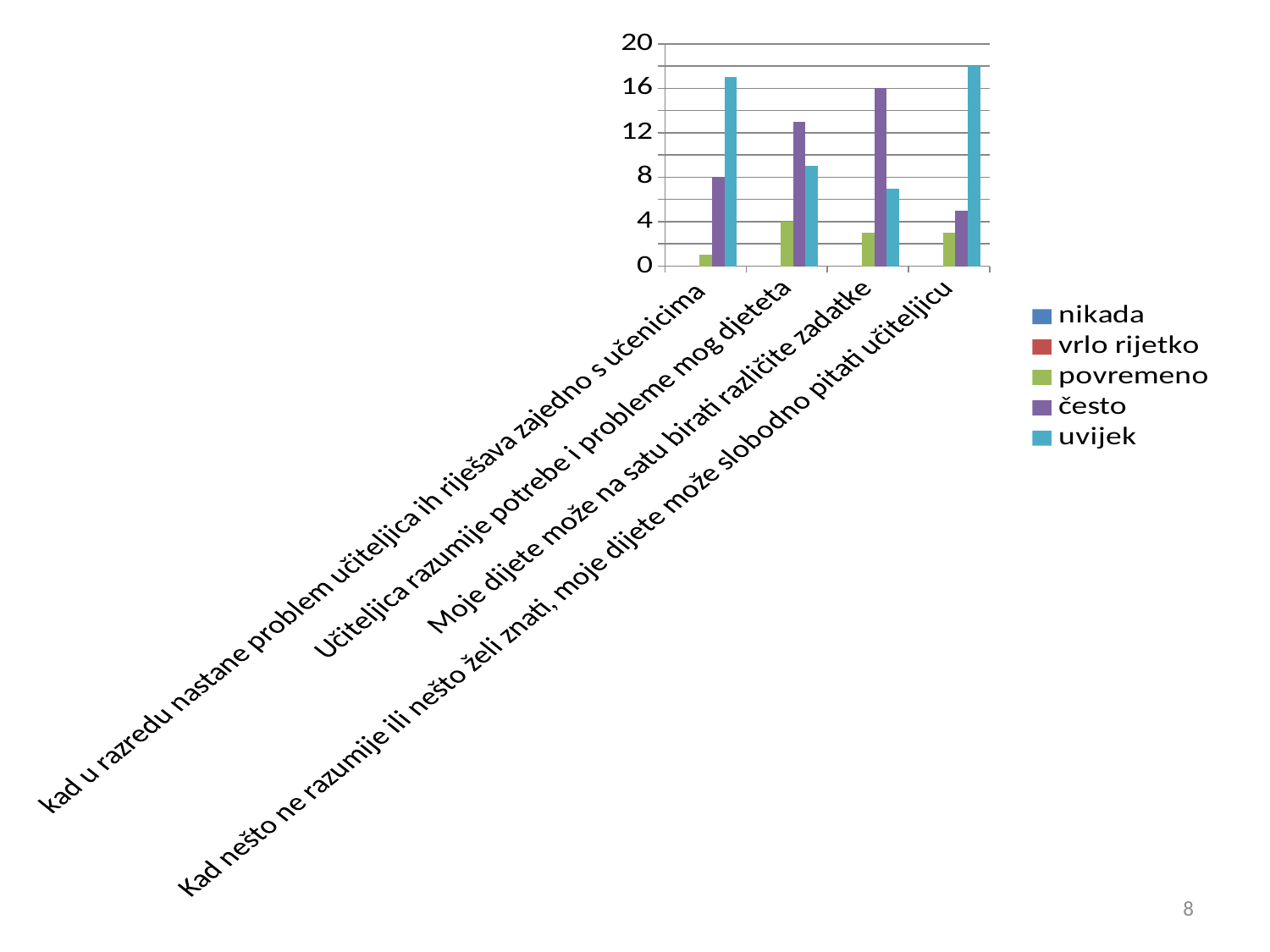
Which series is represented by the light blue bars? uvijek Is the value for 'često' in the category 'Učiteljica razumije potrebe i probleme mog djeteta' greater or less than 12? greater Is the value for 'uvijek' in the category 'Moje dijete može na satu birati različite zadatke' greater or less than 8? less Which category has the highest value for 'često'? Moje dijete može na satu birati različite zadatke How many series does the legend list? 5 In the category 'Moje dijete može na satu birati različite zadatke', which is larger: 'često' or 'uvijek'? često Is the value for 'uvijek' in the category 'Kad nešto ne razumije ili nešto želi znati, moje dijete može slobodno pitati učiteljicu' greater or less than 16? greater What kind of chart is shown on the slide? bar chart Which category has the lowest value for 'uvijek'? Moje dijete može na satu birati različite zadatke In the category 'kad u razredu nastane problem učiteljica ih riješava zajedno s učenicima', which is larger: 'često' or 'uvijek'? uvijek How many categories are shown on the x axis? 4